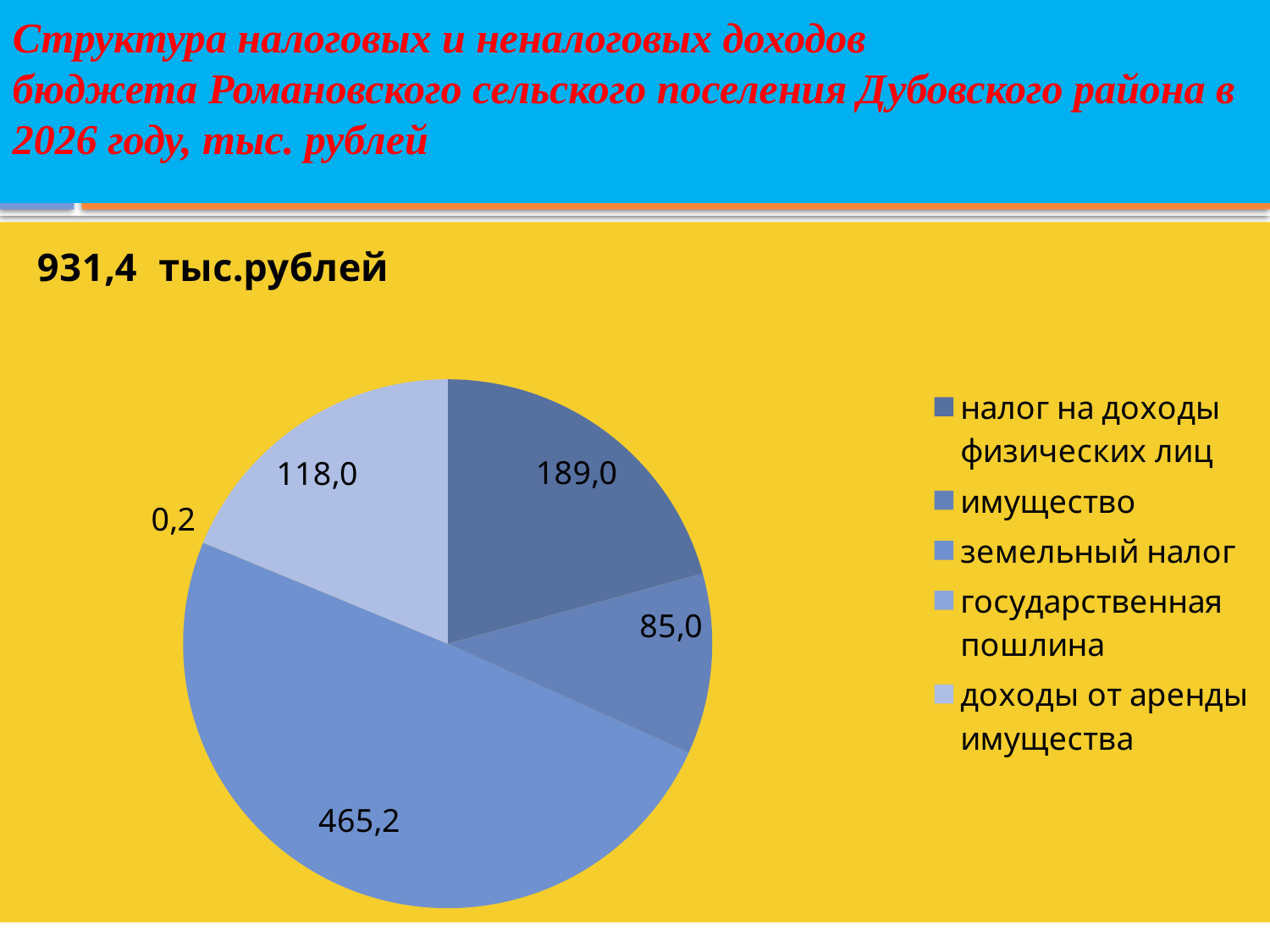
Which is larger, the value for доходы от аренды имущества or the value for имущество? доходы от аренды имущества How many slices does the pie chart have? 5 What is the value for земельный налог? 465,2 Which category has the smallest slice of the pie? государственная пошлина How many entries does the legend list? 5 What is the value for имущество? 85,0 What is the value for доходы от аренды имущества? 118,0 Which category has the largest slice of the pie? земельный налог What type of chart is shown on the slide? pie chart What is the value for налог на доходы физических лиц? 189,0 What is the difference between the values for земельный налог and налог на доходы физических лиц? 276,2 What is the value for государственная пошлина? 0,2